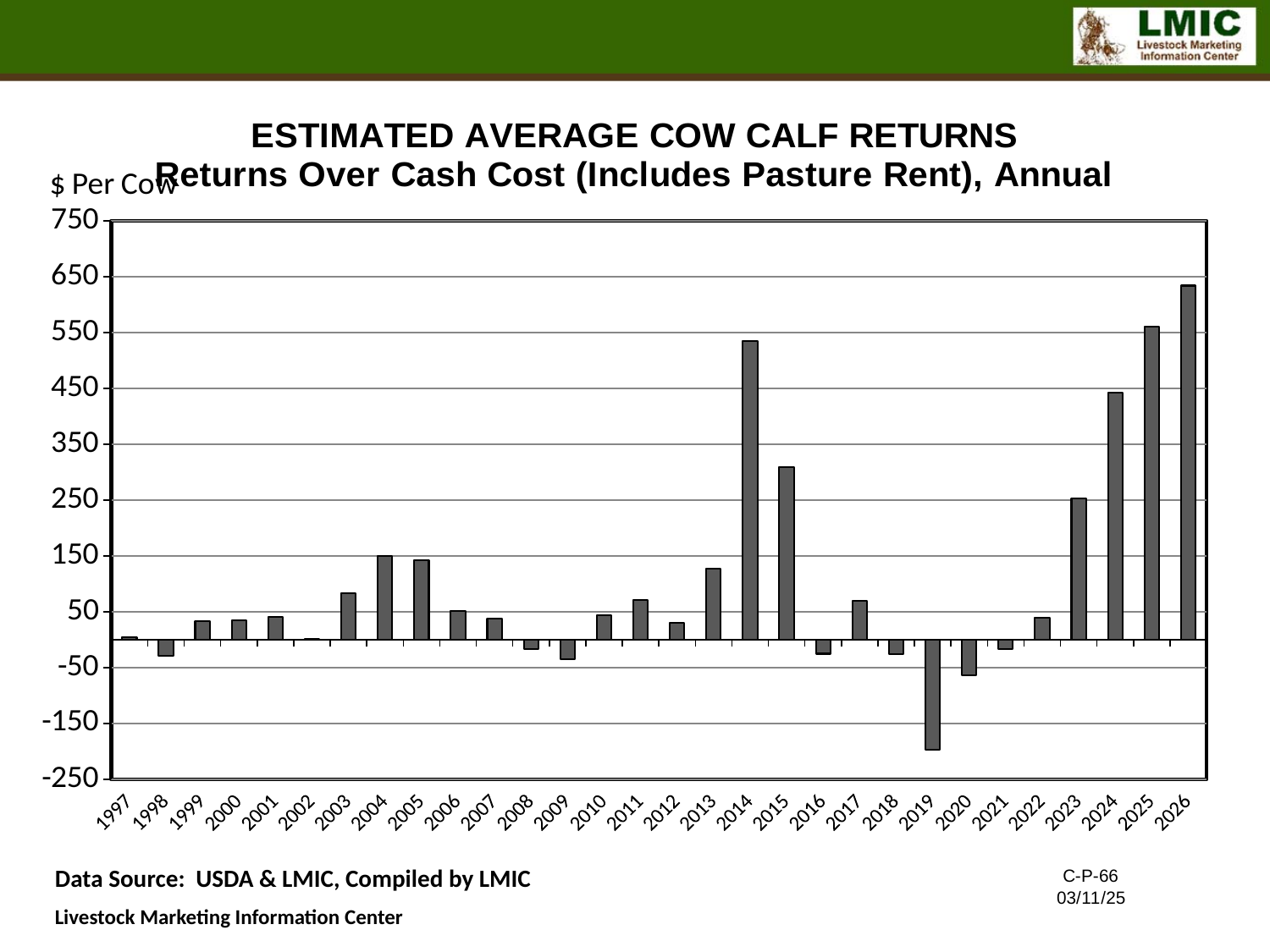
Is the value for 2015 greater or less than 250? greater How many years are plotted on the x axis? 30 Is the value for 2014 greater or less than 450? greater What is the label on the vertical axis? $ Per Cow Is the value for 2019 greater or less than -150? less What kind of chart is shown on the slide? bar chart Which year has the highest returns over cash cost? 2026 Which year has the lowest returns over cash cost? 2019 Do the values rise or fall from 2023 to 2026? rise Which year has the larger value, 2014 or 2015? 2014